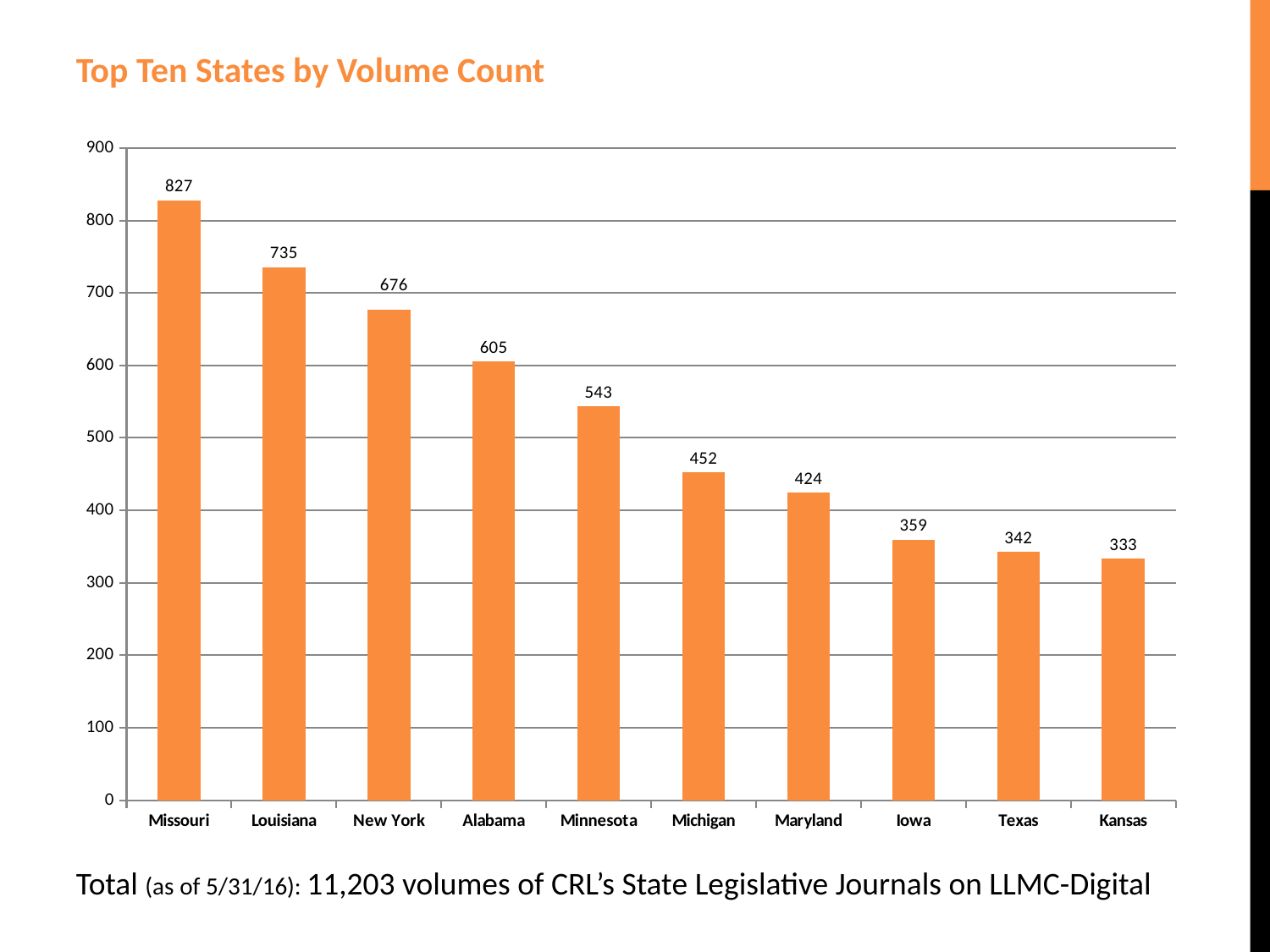
What is the volume count for Missouri? 827 How many states are shown in the chart? 10 What is the volume count for Minnesota? 543 What is the difference between the volume counts for Louisiana and New York? 59 Do the values rise or fall from left to right across the states? Fall Which state has the highest volume count? Missouri What is the difference between the volume counts for Missouri and Kansas? 494 What kind of chart is shown on the slide? Bar chart Is the value for Alabama greater or less than 600? greater Which state has the lowest volume count? Kansas What is the volume count for Texas? 342 Which has a larger volume count, Michigan or Maryland? Michigan